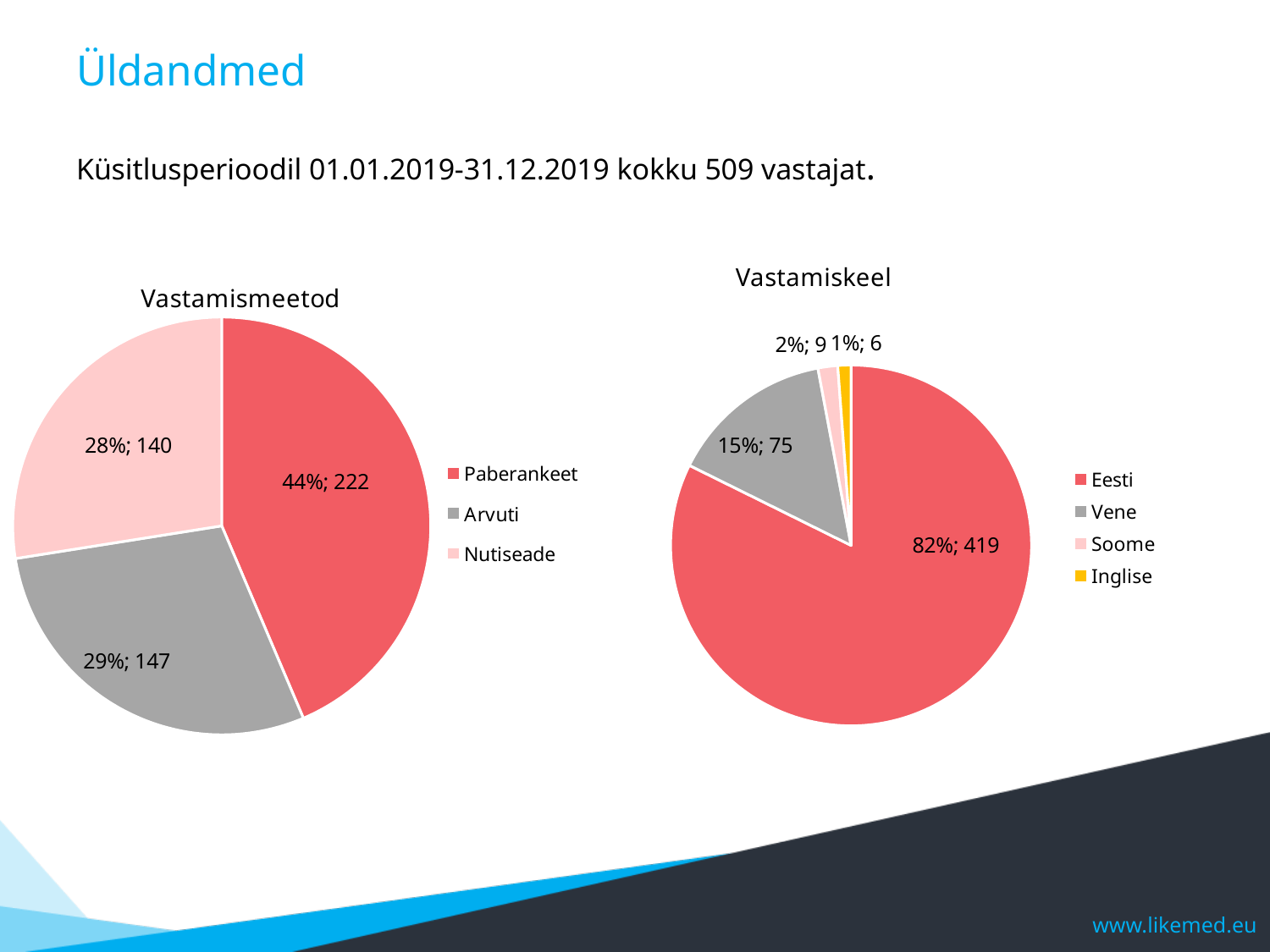
In the Vastamismeetod chart, what percentage share does Nutiseade have? 28% What type of chart is the Vastamiskeel chart? Pie chart In the Vastamiskeel chart, what is the difference between the counts for Eesti and Vene? 344 In the Vastamiskeel chart, what is the count for Vene? 75 In the Vastamismeetod chart, what is the count for Paberankeet? 222 In the Vastamismeetod chart, how many categories are shown? 3 In the Vastamiskeel chart, how many entries does the legend list? 4 In the Vastamiskeel chart, which colour represents Inglise? Yellow In the Vastamismeetod chart, what is the difference between the counts for Arvuti and Nutiseade? 7 In the Vastamiskeel chart, which category has the smallest slice? Inglise In the Vastamiskeel chart, what percentage share does Eesti have? 82% In the Vastamismeetod chart, which category has the largest slice? Paberankeet